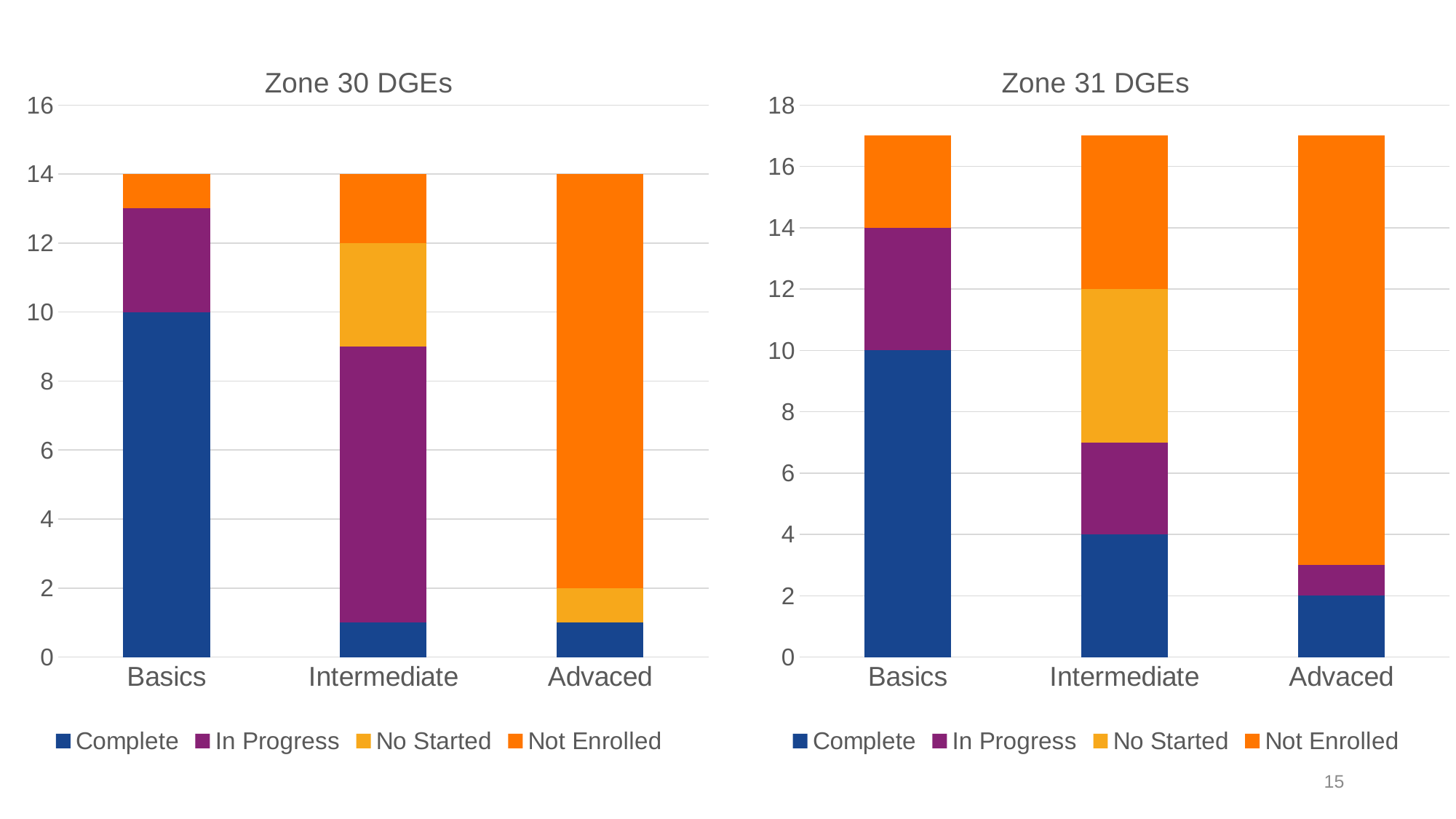
In the Zone 30 DGEs chart, what is the total height of the Basics stacked bar? 14 In the Zone 31 DGEs chart, what is the In Progress value for Basics? 4 In the Zone 31 DGEs chart, is the Not Enrolled value for Advaced greater or less than 10? greater How many series does the legend of the Zone 30 DGEs chart list? 4 In the Zone 31 DGEs chart, what is the Complete value for Advaced? 2 In the Zone 31 DGEs chart, is the Complete value larger for Intermediate or Advaced? Intermediate What kind of chart is the Zone 31 DGEs chart? Stacked bar chart In the Zone 30 DGEs chart, what is the Complete value for Basics? 10 In the Zone 31 DGEs chart, which category has the highest Complete value? Basics In the Zone 31 DGEs chart, which category has the lowest Complete value? Advaced In the Zone 31 DGEs chart, what is the difference between the Complete values for Basics and Intermediate? 6 In the Zone 31 DGEs chart, what is the Complete value for Intermediate? 4